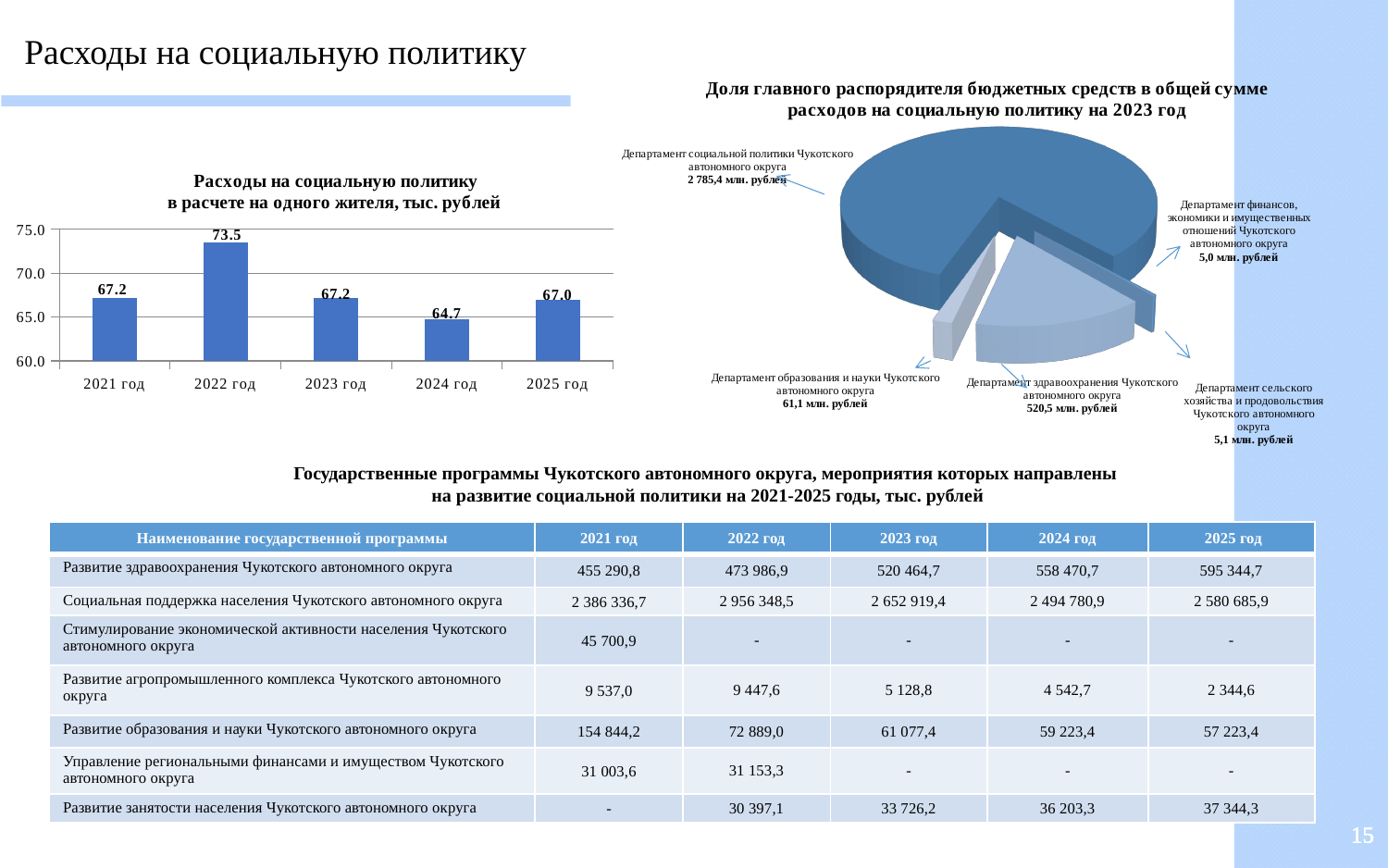
In the bar chart 'Расходы на социальную политику в расчете на одного жителя', do the values rise or fall from 2022 год to 2024 год? fall In the bar chart 'Расходы на социальную политику в расчете на одного жителя', what is the difference between the values for 2022 год and 2024 год? 8.8 In the bar chart 'Расходы на социальную политику в расчете на одного жителя', what is the value for 2022 год? 73.5 In the bar chart 'Расходы на социальную политику в расчете на одного жителя', which year has the lowest value? 2024 год In the pie chart 'Доля главного распорядителя бюджетных средств', what is the value for Департамент здравоохранения Чукотского автономного округа? 520,5 млн. рублей In the bar chart 'Расходы на социальную политику в расчете на одного жителя', what is the value for 2024 год? 64.7 How many years are shown in the bar chart 'Расходы на социальную политику в расчете на одного жителя'? 5 In the bar chart 'Расходы на социальную политику в расчете на одного жителя', is the value for 2022 год greater or less than 70.0? greater What kind of chart is 'Расходы на социальную политику в расчете на одного жителя'? bar chart In the pie chart 'Доля главного распорядителя бюджетных средств', which is larger: Департамент здравоохранения or Департамент образования и науки? Департамент здравоохранения In the bar chart 'Расходы на социальную политику в расчете на одного жителя', which year has the highest value? 2022 год In the pie chart 'Доля главного распорядителя бюджетных средств', which department has the largest share? Департамент социальной политики Чукотского автономного округа